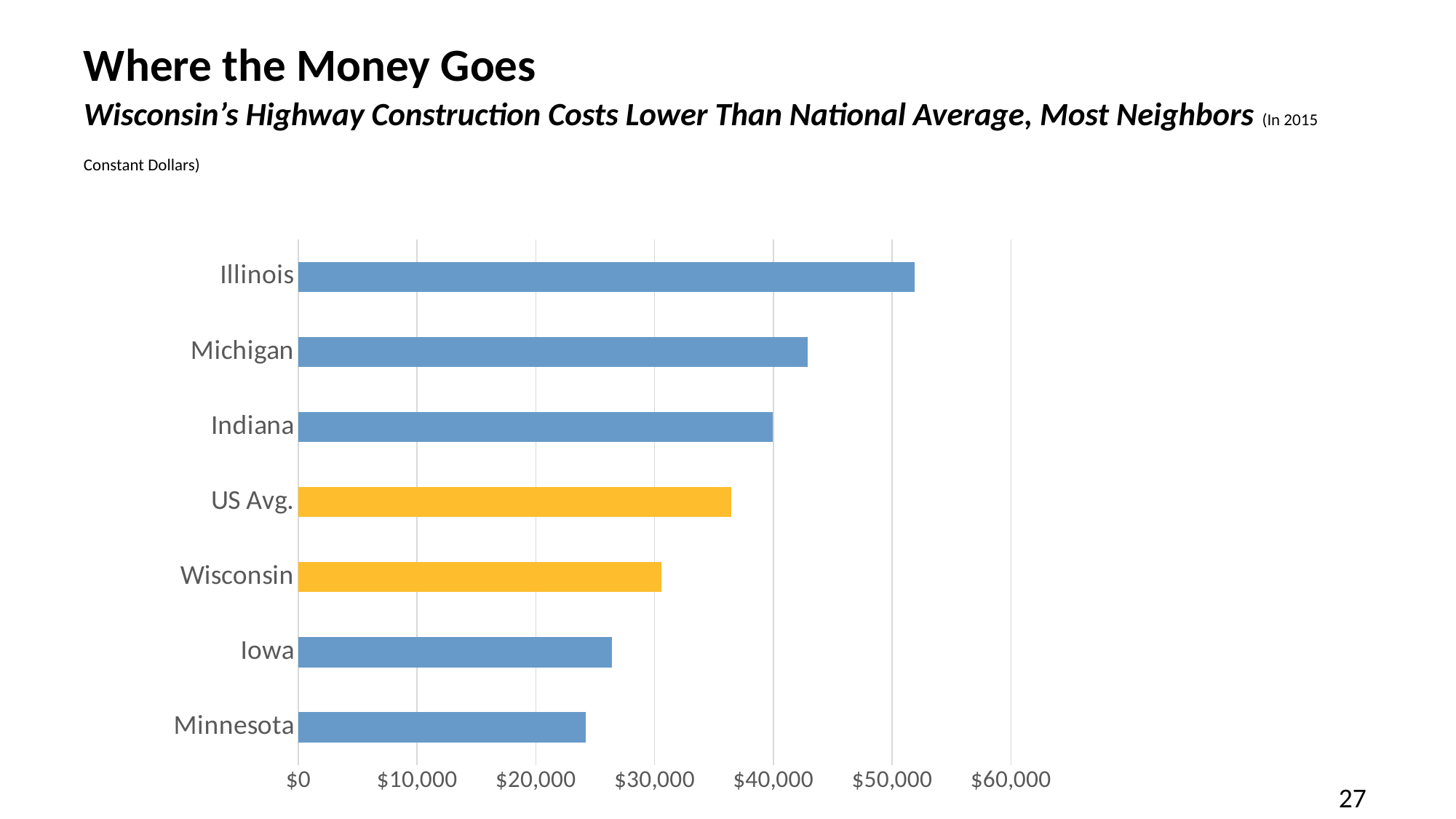
Which two bars in the chart are coloured yellow/orange rather than blue? US Avg. and Wisconsin Which is larger, the value for Iowa or the value for Minnesota? Iowa Is the value for Iowa greater or less than $30,000? less What kind of chart is shown on the slide? Bar chart Is the value for US Avg. greater or less than $40,000? less Which is larger, the value for Wisconsin or the value for US Avg.? US Avg. How many categories (bars) are shown in the chart? 7 What is the main title of the slide? Where the Money Goes Which category has the highest highway construction cost in the chart? Illinois Is the value for Illinois greater or less than $50,000? greater Which category has the lowest highway construction cost in the chart? Minnesota